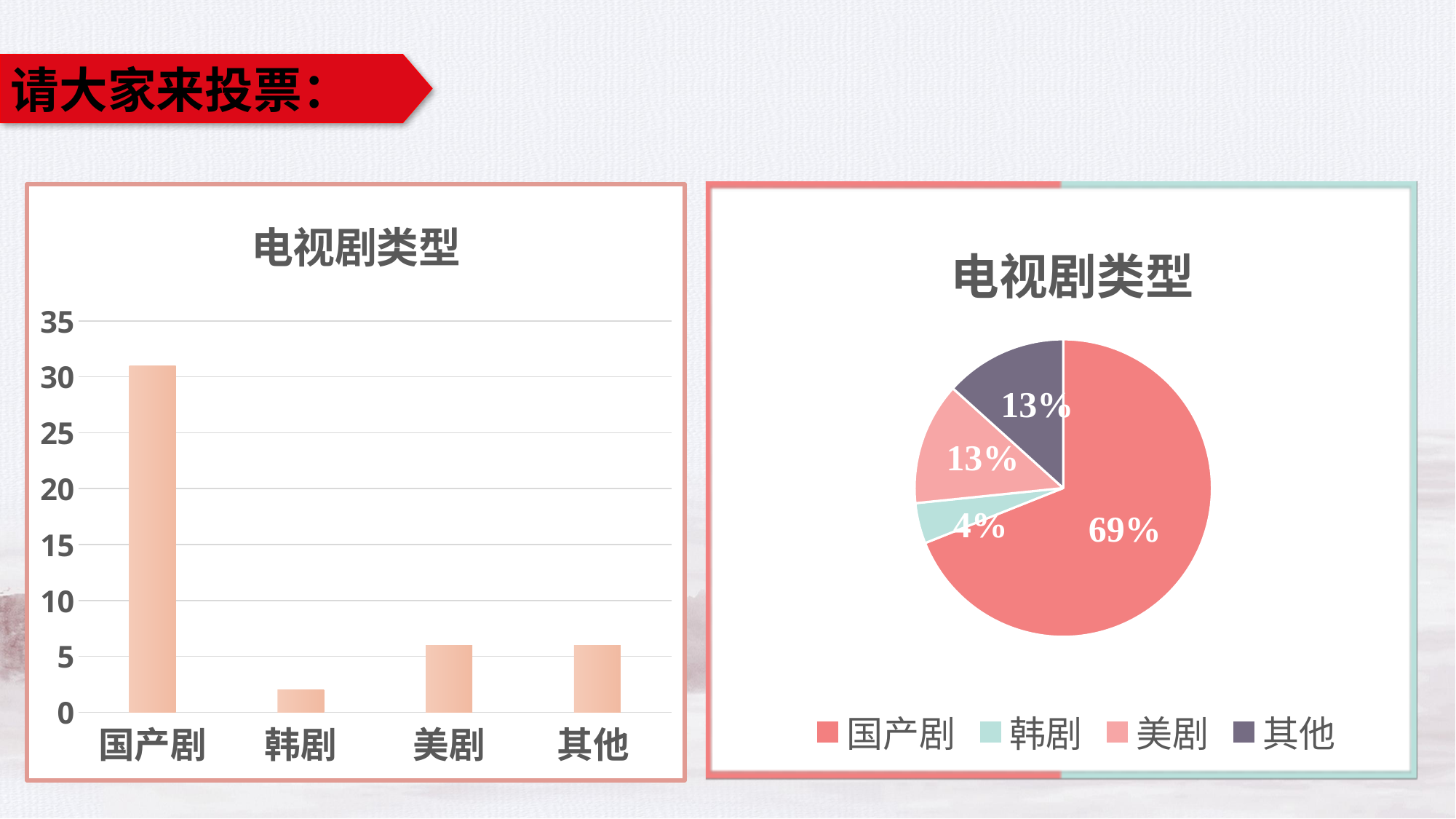
In the bar chart on the left, is the value for 韩剧 greater or less than 5? less In the pie chart on the right, what share does 韩剧 have? 4% What kind of chart is the chart on the left of the slide? bar chart In the bar chart on the left, how many categories are shown on the x axis? 4 In the bar chart on the left, which category has the lowest value? 韩剧 In the pie chart on the right, what is the difference between the shares of 国产剧 and 韩剧? 65% What kind of chart is the chart on the right of the slide? pie chart In the bar chart on the left, is the value for 美剧 greater or less than 10? less In the pie chart on the right, how many entries does the legend list? 4 In the pie chart on the right, what share does 国产剧 have? 69% In the bar chart on the left, is the value for 国产剧 greater or less than 25? greater In the bar chart on the left, which category has the highest value? 国产剧